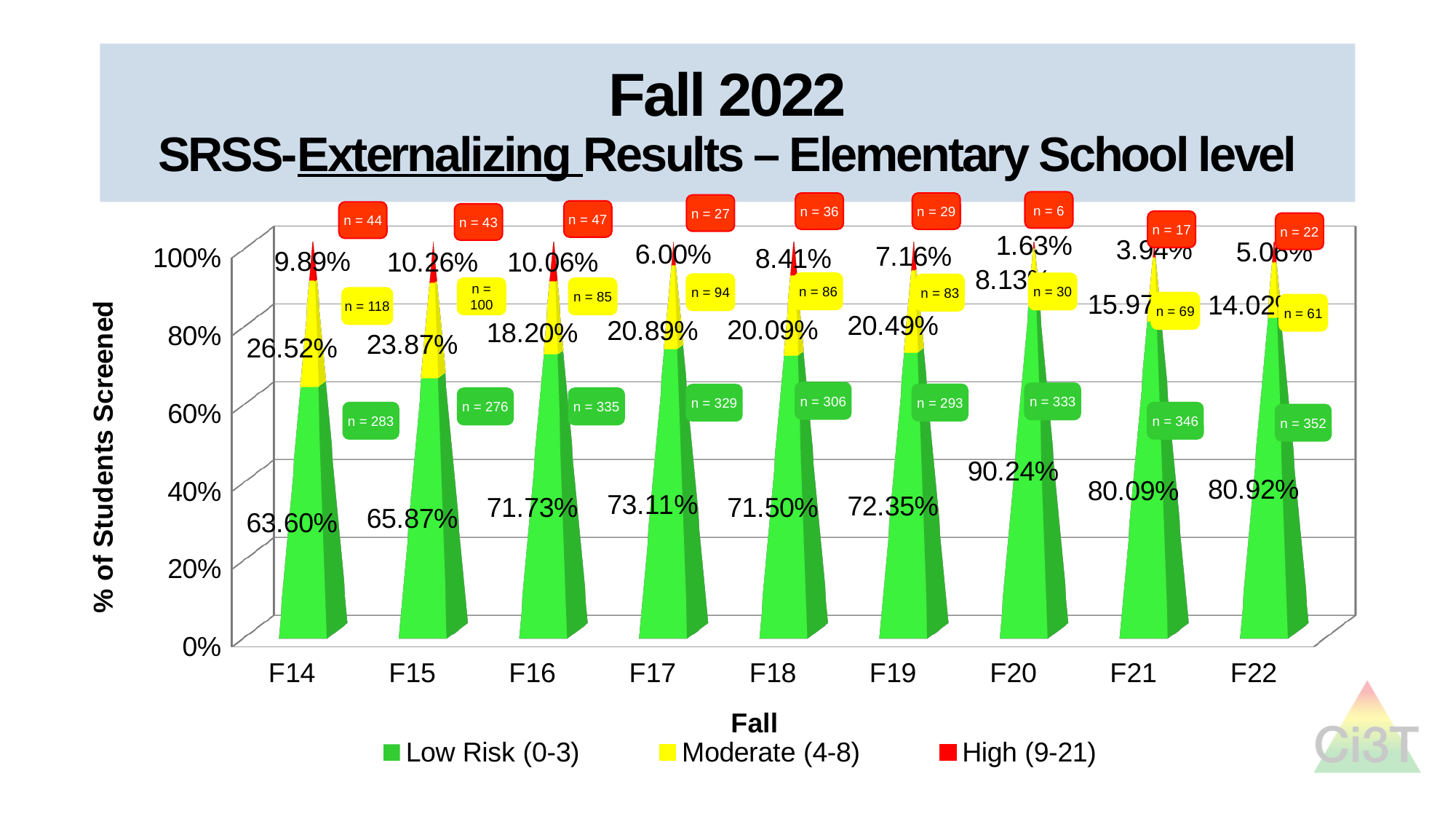
What percentage of students screened were Moderate (4-8) in F14? 26.52% Which fall has the lowest Low Risk (0-3) percentage? F14 What is the Low Risk (0-3) percentage for F22? 80.92% Which fall has the highest Low Risk (0-3) percentage? F20 What percentage of students screened were High (9-21) in F17? 6.00% How many fall screening periods are shown on the x axis? 9 What percentage of students screened were Low Risk (0-3) in F20? 90.24% Is the Moderate (4-8) percentage larger in F14 or in F16? F14 What is the difference between the Low Risk (0-3) percentages for F20 and F14? 26.64% What is the label of the y axis? % of Students Screened How many series does the legend list? 3 Which fall has the highest High (9-21) percentage? F15